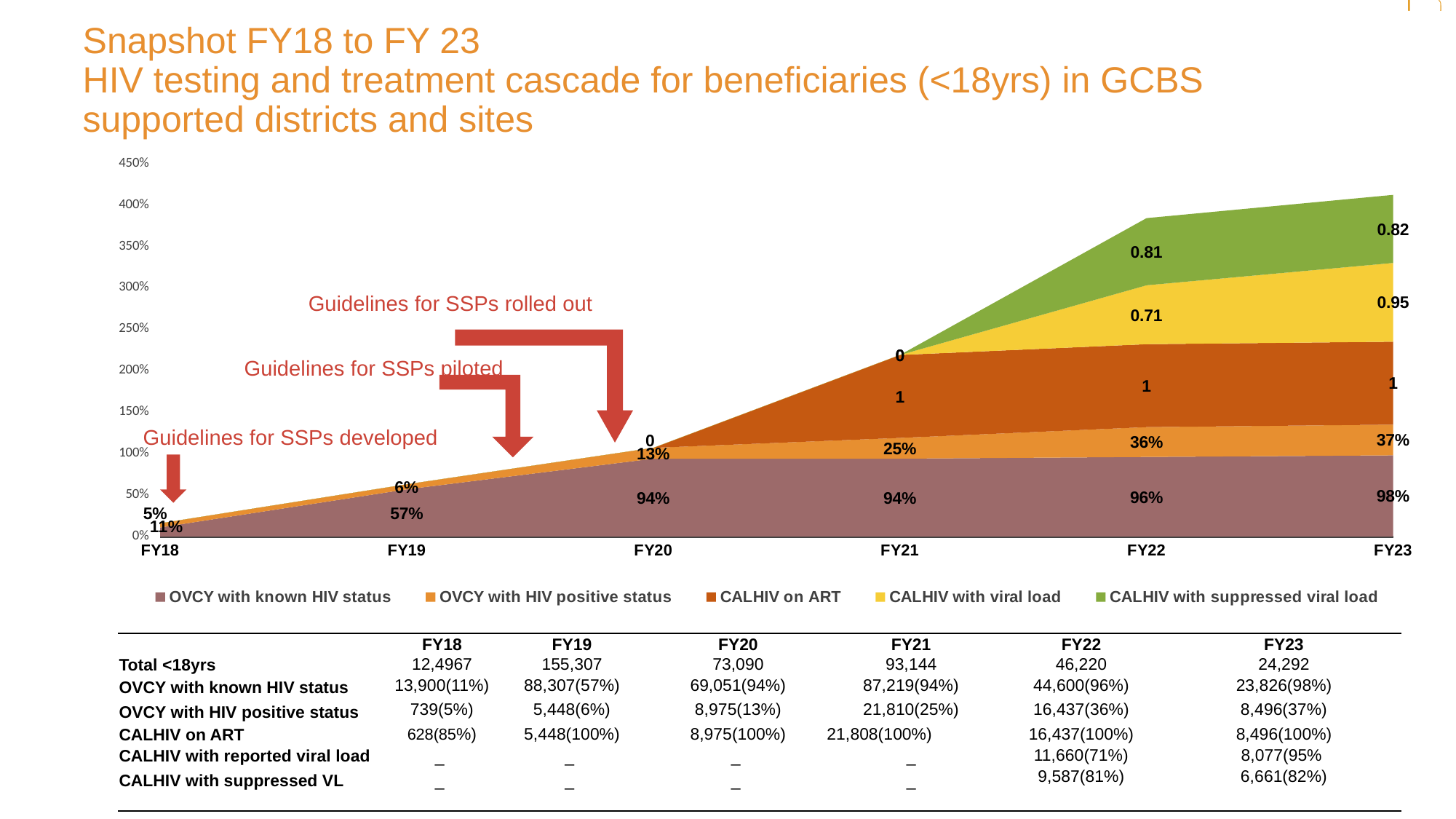
What is the value for OVCY with HIV positive status in FY22? 36% How many fiscal years are shown on the x axis of the chart? 6 What is the value labelled for CALHIV with viral load in FY23? 0.95 In which fiscal year is OVCY with known HIV status highest? FY23 What is the value for OVCY with known HIV status in FY19? 57% In which fiscal year is OVCY with known HIV status lowest? FY18 What kind of chart is shown on the slide? Area chart Which is larger for OVCY with HIV positive status: FY20 or FY21? FY21 Does OVCY with known HIV status rise or fall from FY18 to FY23? Rises How many series does the chart legend list? 5 By how many percentage points does OVCY with HIV positive status in FY23 exceed FY18? 32 percentage points What is the value labelled for CALHIV with suppressed viral load in FY22? 0.81